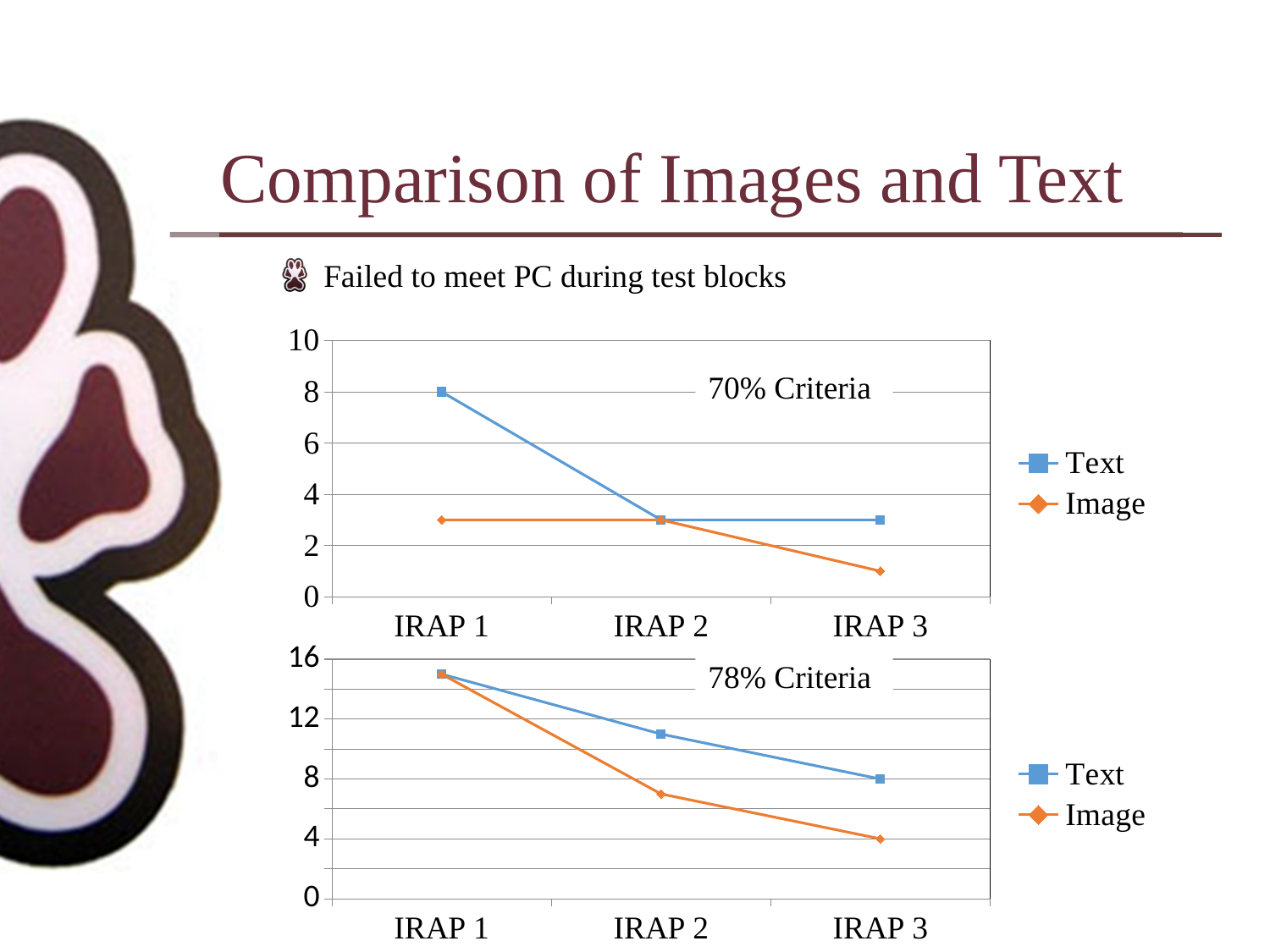
What kind of chart is the "70% Criteria" chart? line chart In the "78% Criteria" chart, what is the value for Image at IRAP 3? 4 In the "78% Criteria" chart, what is the difference between the Text and Image values at IRAP 3? 4 In the "70% Criteria" chart, at which IRAP is the Text series highest? IRAP 1 How many categories are shown on the x axis of the "70% Criteria" chart? 3 How many series does the legend of the "78% Criteria" chart list? 2 In the "70% Criteria" chart, what is the value for Text at IRAP 1? 8 In the "70% Criteria" chart, does the Text series rise or fall from IRAP 1 to IRAP 3? fall In the "70% Criteria" chart, is the value for Image at IRAP 1 greater or less than 4? less In the "78% Criteria" chart, what is the value for Text at IRAP 3? 8 In the "70% Criteria" chart, which series has the larger value at IRAP 1, Text or Image? Text In the "78% Criteria" chart, is the value for Text at IRAP 2 greater or less than 8? greater